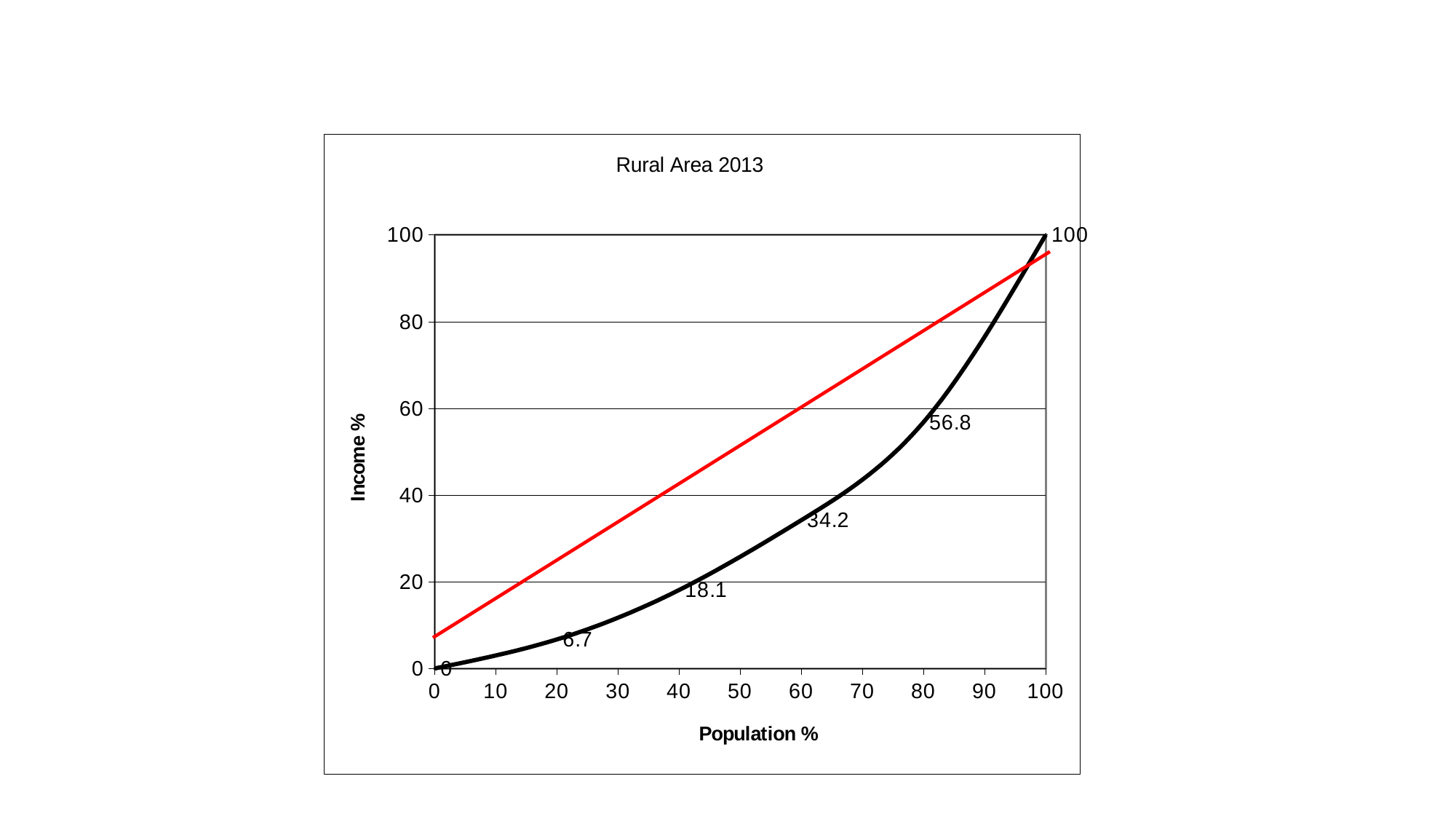
What is the Income % value of the black curve at Population % 80? 56.8 What is the difference between the black curve's values at Population % 80 and Population % 60? 22.6 What is the title of the chart? Rural Area 2013 How many labeled data points are on the black curve? 6 What is the difference between the black curve's values at Population % 40 and Population % 20? 11.4 Does the black curve rise or fall as Population % increases? rises What is the Income % value of the black curve at Population % 100? 100 What is the Income % value of the black curve at Population % 60? 34.2 What is the Income % value of the black curve at Population % 20? 6.7 What kind of chart is shown on the slide? line chart What is the Income % value of the black curve at Population % 40? 18.1 Is the value of the red line at Population % 60 greater or less than 40? greater